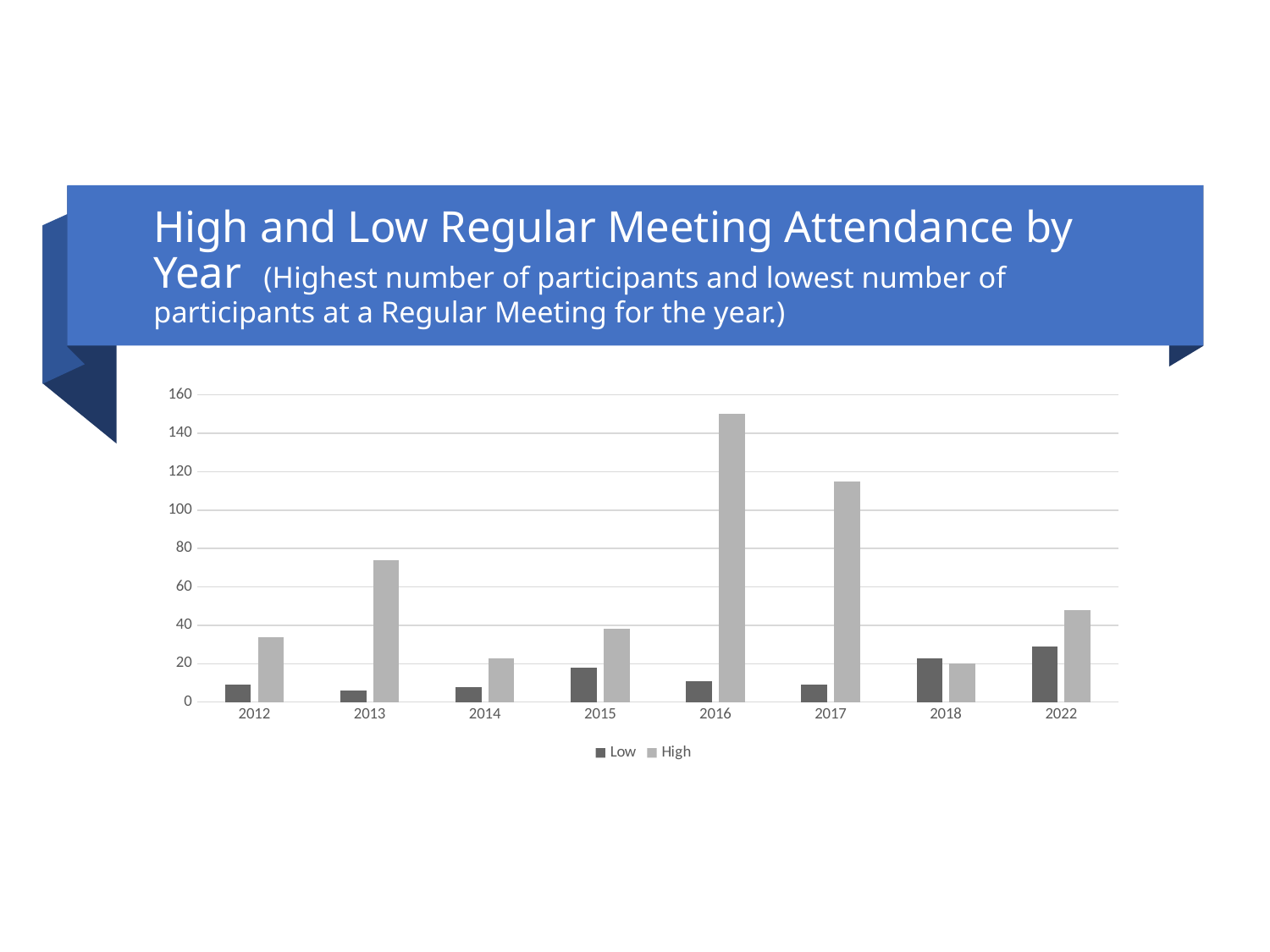
What kind of chart is shown on the slide? bar chart Which is larger, the High value for 2016 or the High value for 2017? 2016 Which year has the highest High attendance value? 2016 Which year has the highest Low attendance value? 2022 How many years are shown on the x axis of the chart? 8 Is the High value for 2017 greater or less than 100? greater How many series does the chart legend list? 2 Is the High value for 2016 greater or less than 140? greater What are the two series named in the chart legend? Low and High Is the Low value for 2022 greater or less than 40? less Does the High series rise or fall from 2016 to 2018? fall